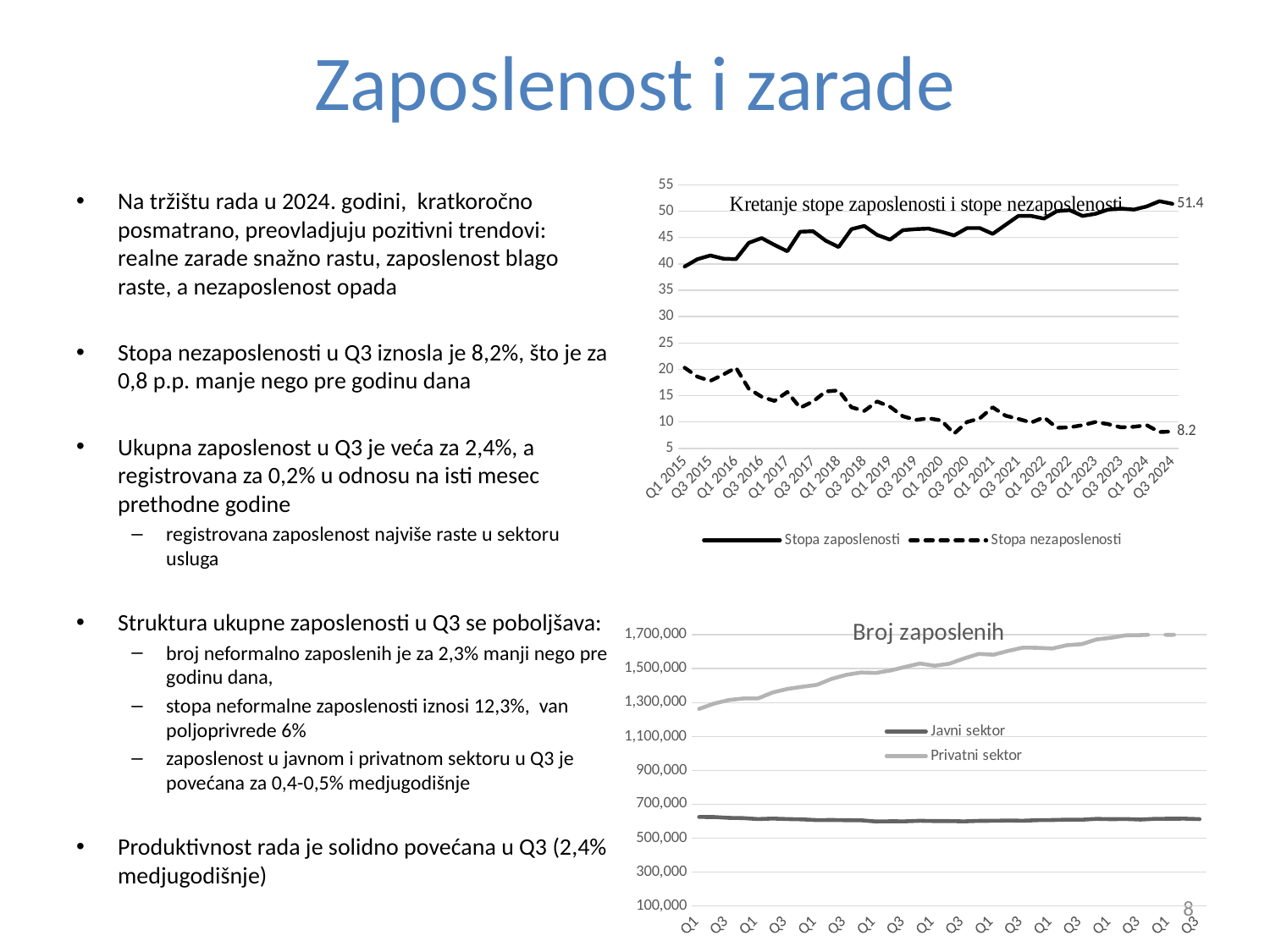
In the chart titled "Broj zaposlenih", which series has higher values, Javni sektor or Privatni sektor? Privatni sektor What kind of chart is the chart titled "Broj zaposlenih"? line chart In the chart titled "Kretanje stope zaposlenosti i stope nezaposlenosti", what is the difference between the two labelled end values, 51.4 and 8.2? 43.2 In the chart titled "Kretanje stope zaposlenosti i stope nezaposlenosti", which series is drawn with a dashed line? Stopa nezaposlenosti In the chart titled "Broj zaposlenih", is the Javni sektor series greater or less than 900,000 throughout the period? less In the chart titled "Kretanje stope zaposlenosti i stope nezaposlenosti", what is the last labelled value of the Stopa zaposlenosti series? 51.4 In the chart titled "Kretanje stope zaposlenosti i stope nezaposlenosti", what is the last labelled value of the Stopa nezaposlenosti series? 8.2 In the chart titled "Broj zaposlenih", how many series does the legend list? 2 In the chart titled "Kretanje stope zaposlenosti i stope nezaposlenosti", does the Stopa zaposlenosti series rise or fall from Q1 2015 to Q3 2024? rise In the chart titled "Kretanje stope zaposlenosti i stope nezaposlenosti", how many series does the legend list? 2 In the chart titled "Kretanje stope zaposlenosti i stope nezaposlenosti", does the Stopa nezaposlenosti series rise or fall from Q1 2015 to Q3 2024? fall